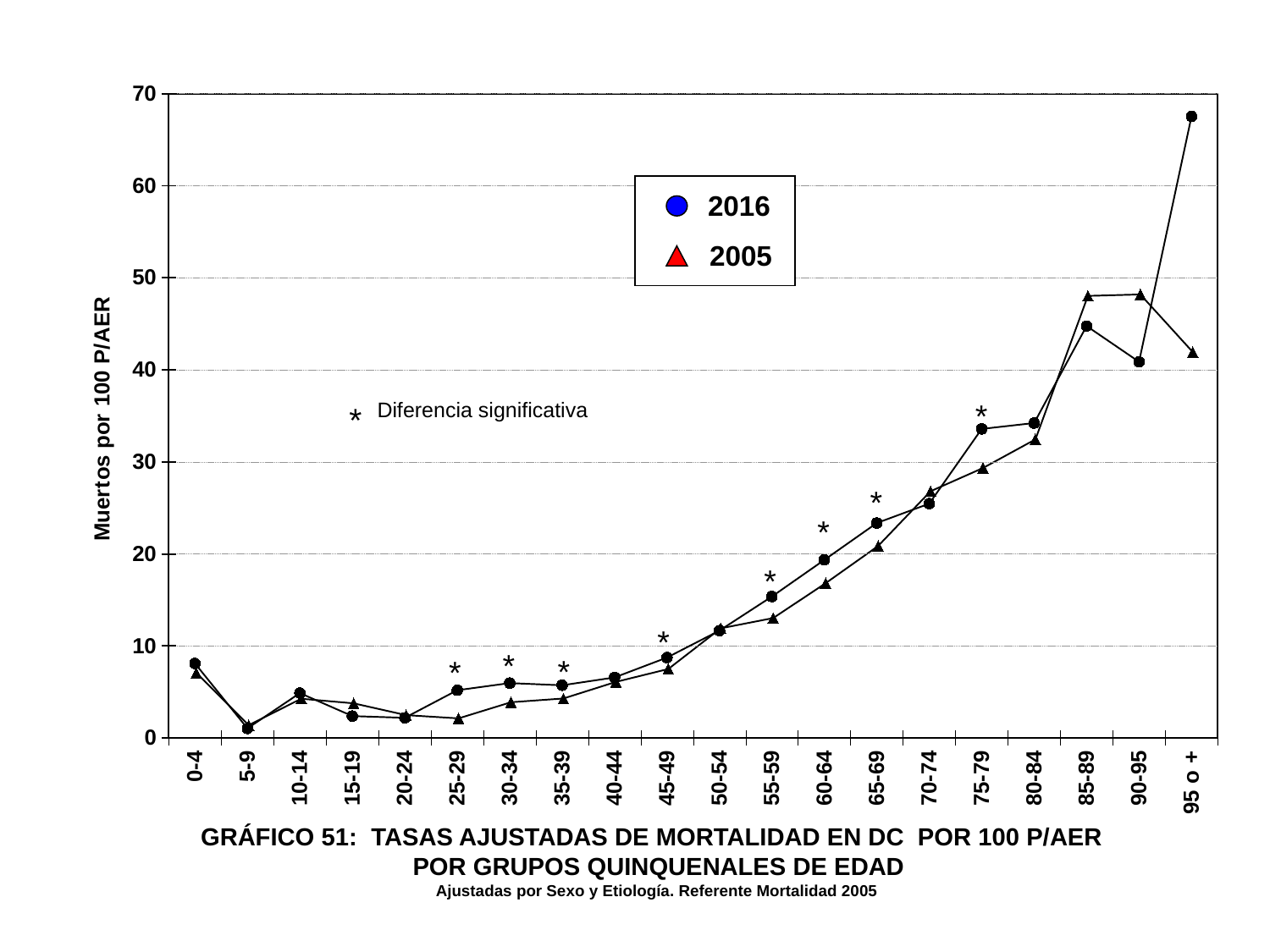
For the 2016 series, which age group has the highest value? 95 o + For the 85-89 age group, which series has the larger value, 2016 or 2005? 2005 Is the 2016 value for the 75-79 age group greater or less than 30? greater How many age groups are shown on the x axis? 20 Is the 2016 value for the 95 o + age group greater or less than 60? greater Is the 2005 value for the 85-89 age group greater or less than 40? greater For the 60-64 age group, which series has the larger value, 2016 or 2005? 2016 Do the 2016 values rise or fall from the 50-54 age group to the 85-89 age group? rise What kind of chart is shown on the slide? line chart For the 2016 series, which age group has the lowest value? 5-9 How many series does the legend list? 2